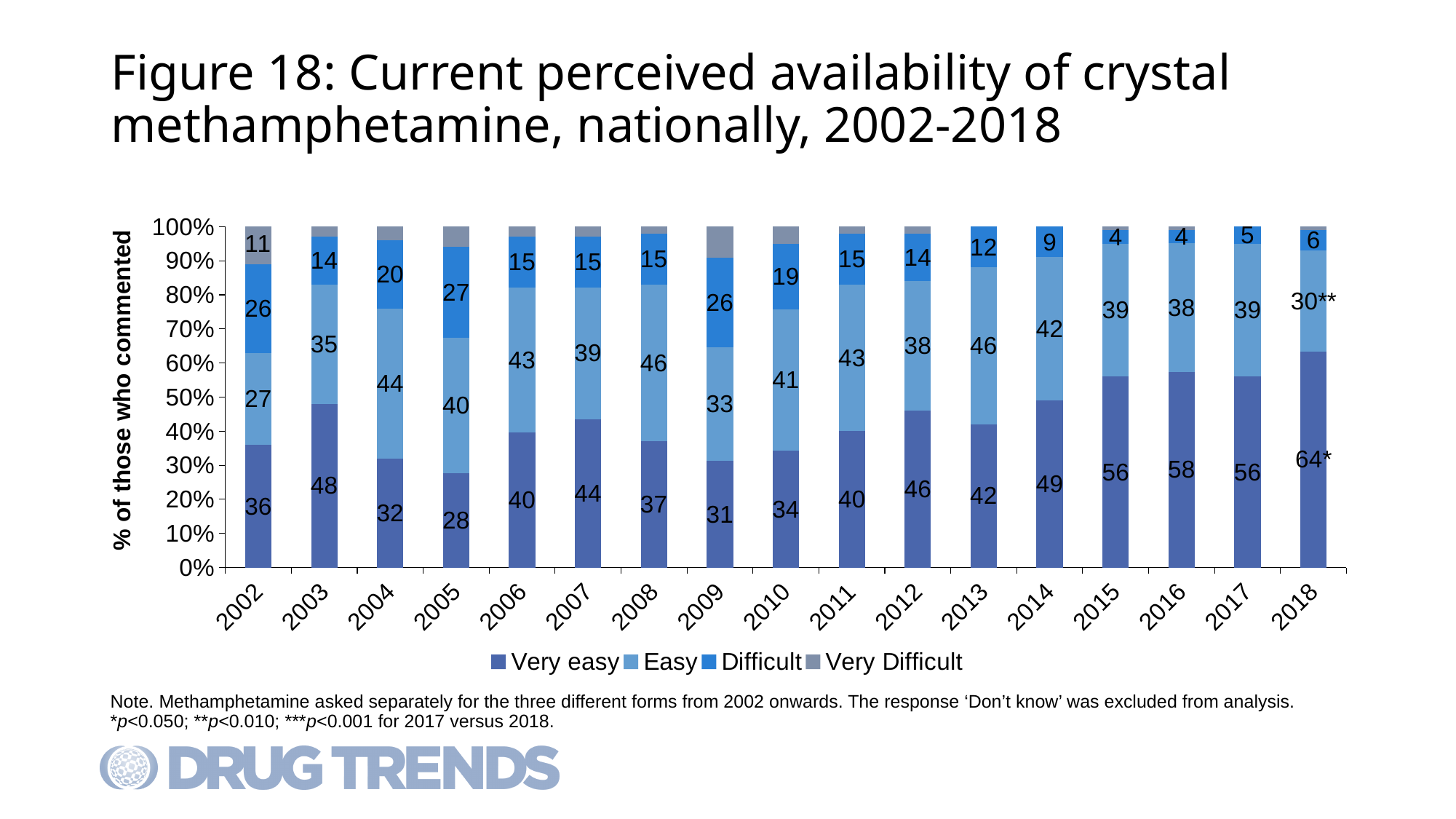
Which year had a larger 'Difficult' share, 2002 or 2013? 2002 What percentage of respondents rated crystal methamphetamine as 'Very easy' to obtain in 2003? 48 What is the 'Easy' value for 2004? 44 What is the 'Difficult' value for 2010? 19 Does the 'Very easy' share generally rise or fall from 2009 to 2018? rise What is the 'Very Difficult' value for 2002? 11 In which year was the 'Very easy' share lowest? 2005 By how many percentage points did the 'Very easy' share change from 2017 to 2018? 8 How many series does the legend list? 4 In which year was the 'Very easy' share highest? 2018 How many years are shown on the x axis? 17 What type of chart is shown on the slide? stacked bar chart